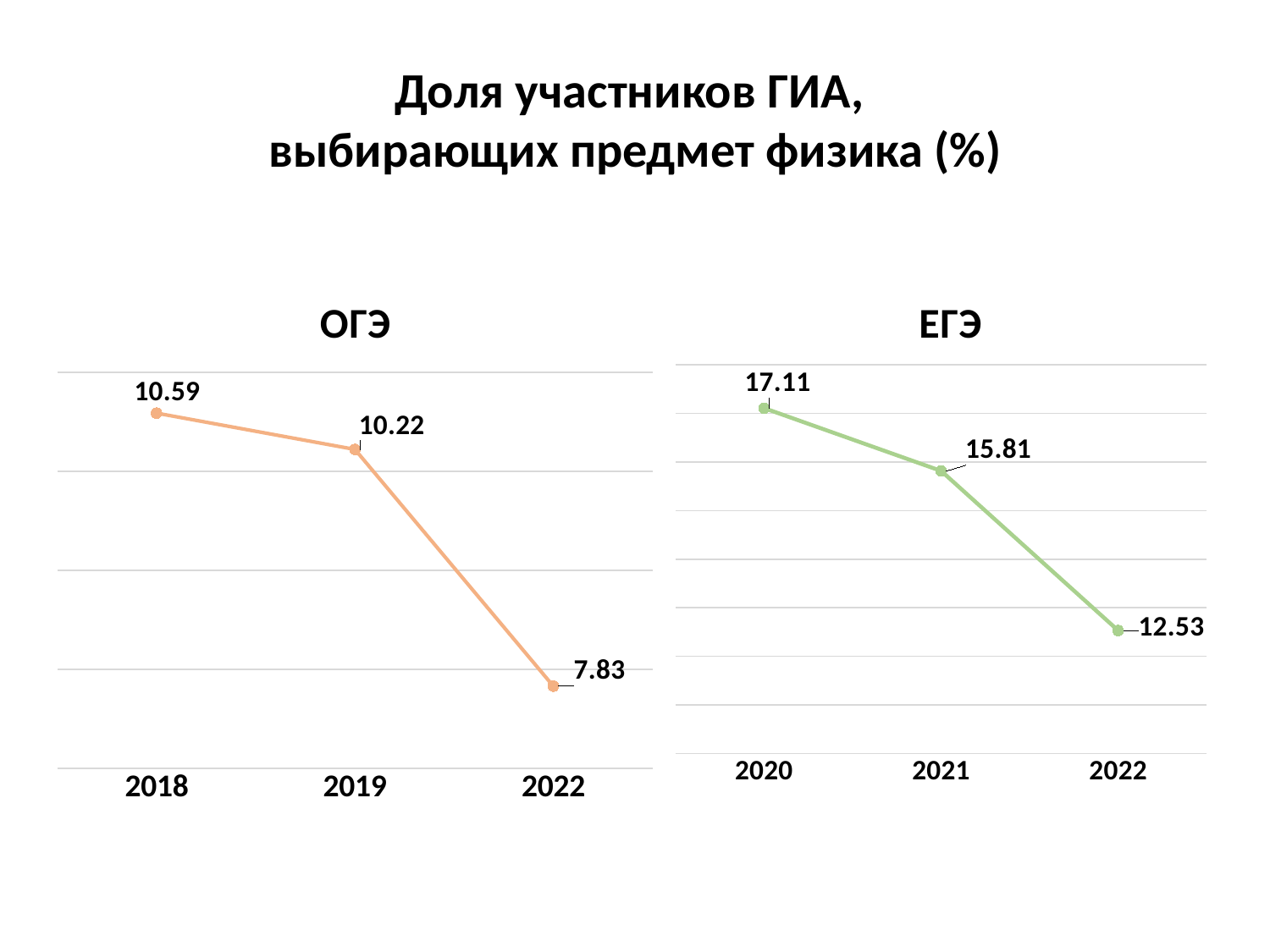
In the ЕГЭ chart, what is the value for 2022? 12.53 In the ОГЭ chart, what is the value for 2022? 7.83 In the ЕГЭ chart, what is the value for 2021? 15.81 In the ЕГЭ chart, do the values rise or fall from 2020 to 2022? Fall In the ЕГЭ chart, which year has the lowest value? 2022 In the ОГЭ chart, which year has the highest value? 2018 In the ОГЭ chart, what is the difference between the values for 2019 and 2022? 2.39 What kind of chart is the ОГЭ chart? Line chart In the ОГЭ chart, what is the value for 2018? 10.59 How many data points are plotted in the ЕГЭ chart? 3 Which is larger: the ОГЭ value for 2019 or the ЕГЭ value for 2021? ЕГЭ value for 2021 In the ЕГЭ chart, what is the difference between the values for 2020 and 2022? 4.58